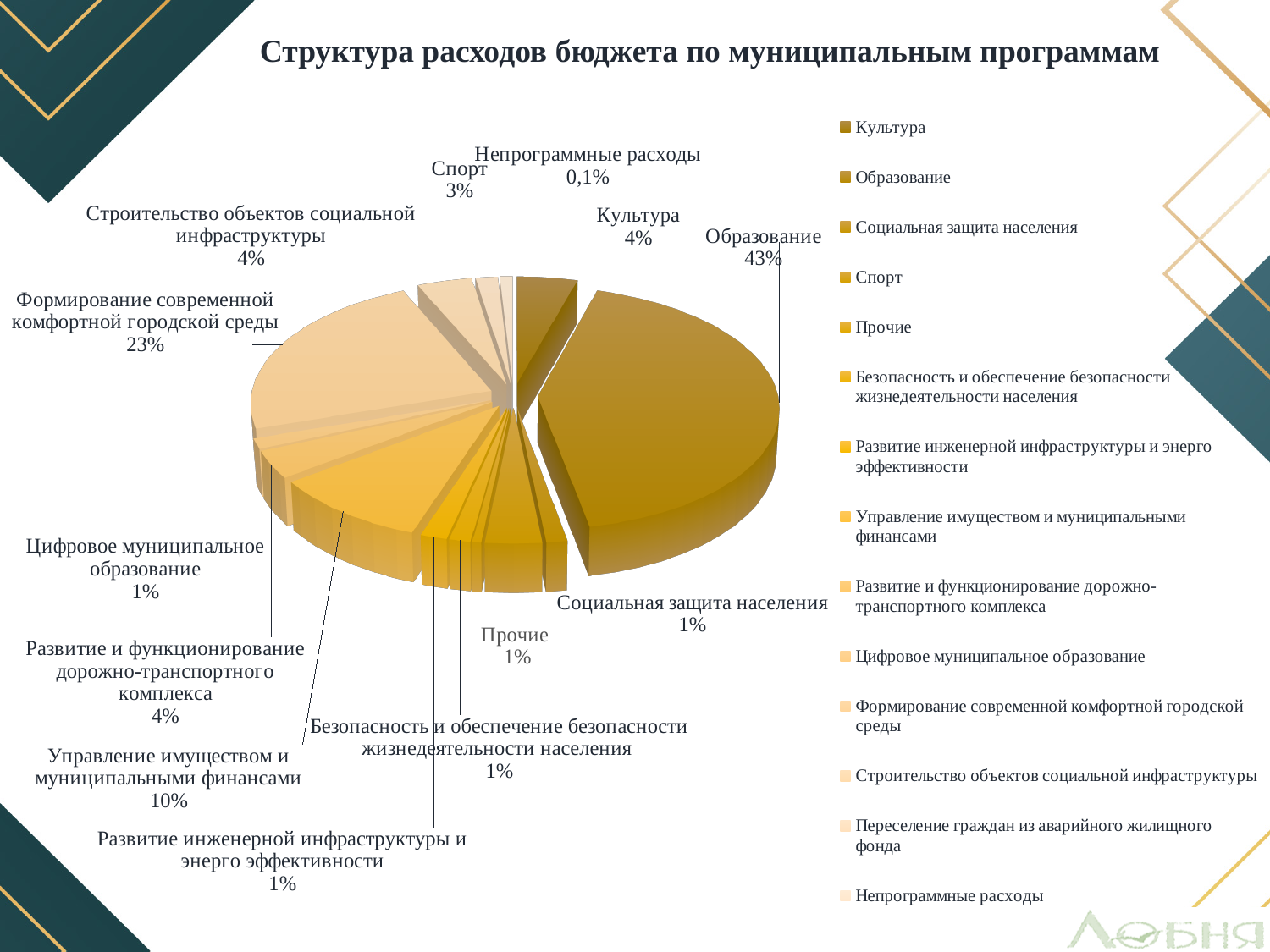
What kind of chart is shown on the slide? Pie chart What share is shown for Непрограммные расходы? 0,1% Which category has the smallest labelled share of the pie? Непрограммные расходы What is the title of the chart? Структура расходов бюджета по муниципальным программам What is the difference in percentage points between Образование and Формирование современной комфортной городской среды? 20 What share is shown for Формирование современной комфортной городской среды? 23% Which is larger: the share for Управление имуществом и муниципальными финансами or the share for Культура? Управление имуществом и муниципальными финансами How many entries does the legend list? 14 What share is shown for Спорт? 3% Which category has the largest share of the pie? Образование What share of the pie does Образование have? 43% What share is shown for Управление имуществом и муниципальными финансами? 10%